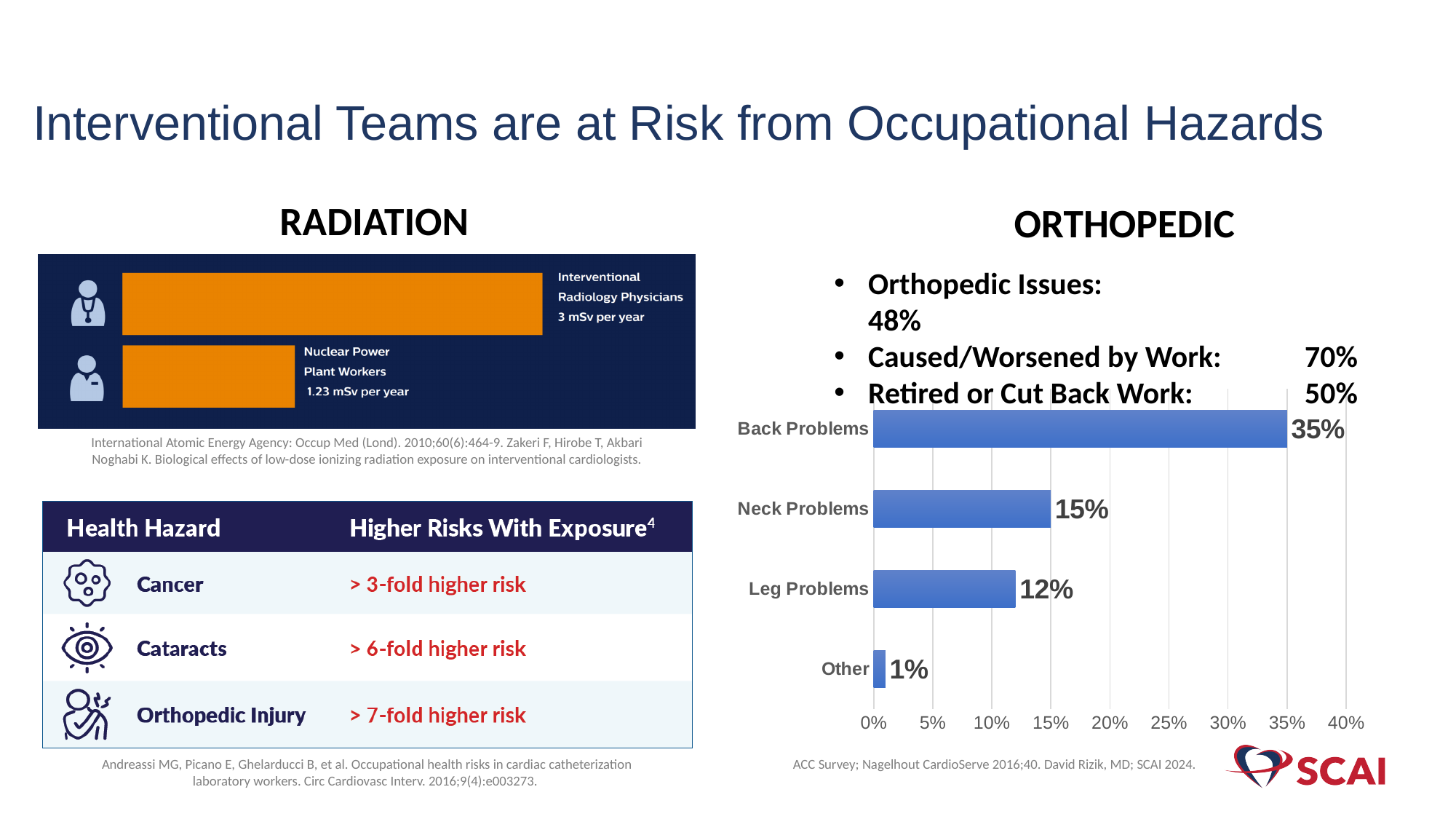
In the orthopedic bar chart on the right, what is the value for Other? 1% In the orthopedic bar chart on the right, what is the value for Neck Problems? 15% In the radiation chart on the left, what is the annual dose shown for Nuclear Power Plant Workers? 1.23 mSv per year In the orthopedic bar chart on the right, what is the value for Back Problems? 35% What kind of chart is the orthopedic chart on the right? Bar chart In the orthopedic bar chart on the right, what is the value for Leg Problems? 12% In the orthopedic bar chart on the right, which is larger, Neck Problems or Leg Problems? Neck Problems In the orthopedic bar chart on the right, which category has the highest value? Back Problems In the orthopedic bar chart on the right, what is the difference between Back Problems and Neck Problems? 20% In the orthopedic bar chart on the right, which category has the lowest value? Other In the orthopedic bar chart on the right, how many categories are shown? 4 In the radiation chart on the left, what is the annual dose shown for Interventional Radiology Physicians? 3 mSv per year